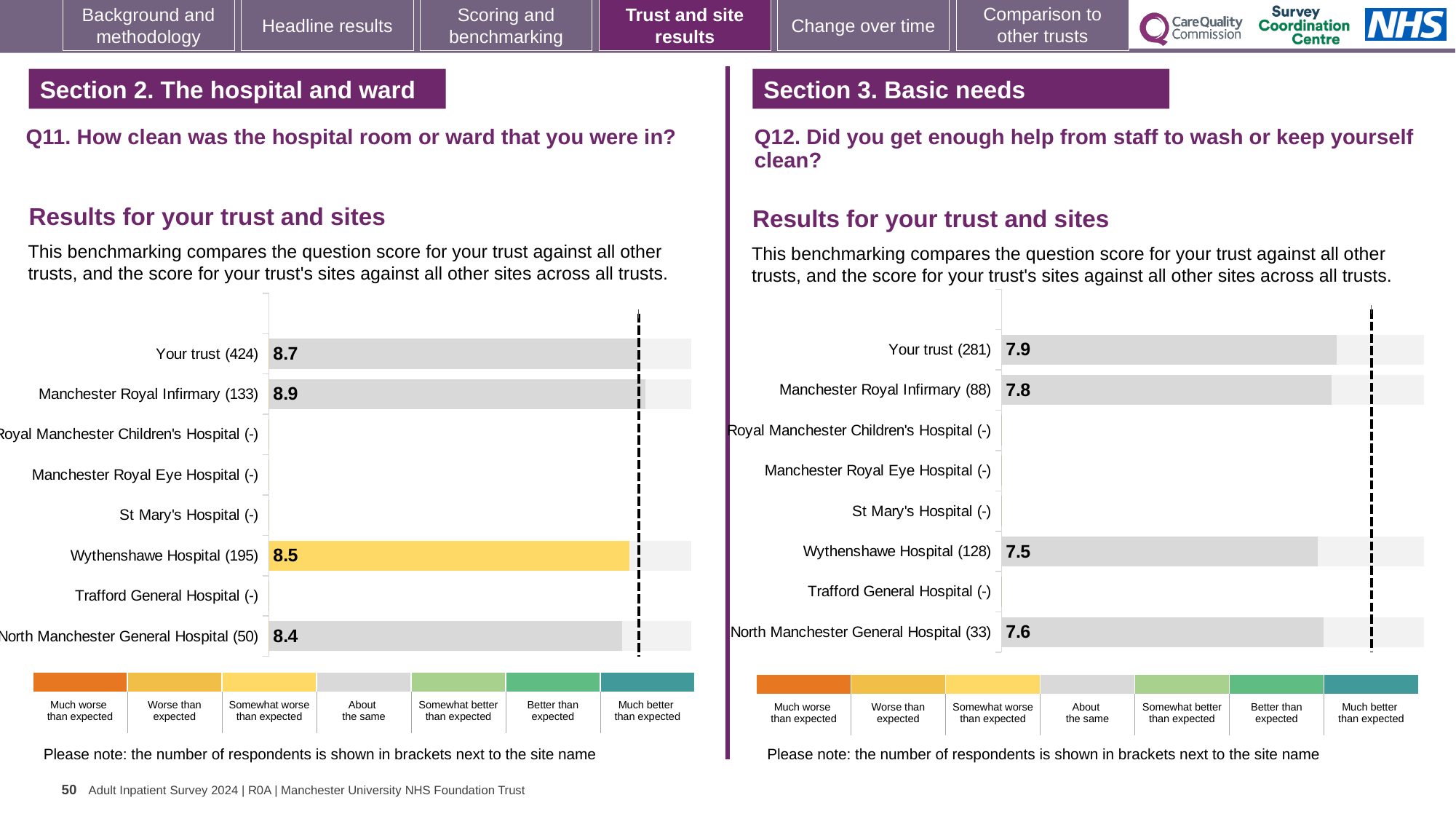
How many site/trust categories are listed on the Q12 chart's vertical axis? 8 On the Q12 chart, is the score for Manchester Royal Infirmary larger or smaller than the score for Wythenshawe Hospital? larger On the Q11 chart, what is the difference between the scores for Manchester Royal Infirmary and North Manchester General Hospital? 0.5 On the Q11 chart, what is the score for Wythenshawe Hospital? 8.5 On the Q11 chart (How clean was the hospital room or ward), what is the score for Your trust? 8.7 On the Q11 chart, which site's bar is coloured yellow, indicating 'Somewhat worse than expected'? Wythenshawe Hospital On the Q11 chart, which site with a plotted score has the lowest score? North Manchester General Hospital On the Q12 chart, what is the score for North Manchester General Hospital? 7.6 On the Q11 chart, how many respondents are shown in brackets for Wythenshawe Hospital? 195 On the Q11 chart, which site has the highest score? Manchester Royal Infirmary On the Q12 chart (Did you get enough help from staff to wash or keep yourself clean), what is the score for Your trust? 7.9 On the Q12 chart, which site with a plotted score has the lowest score? Wythenshawe Hospital